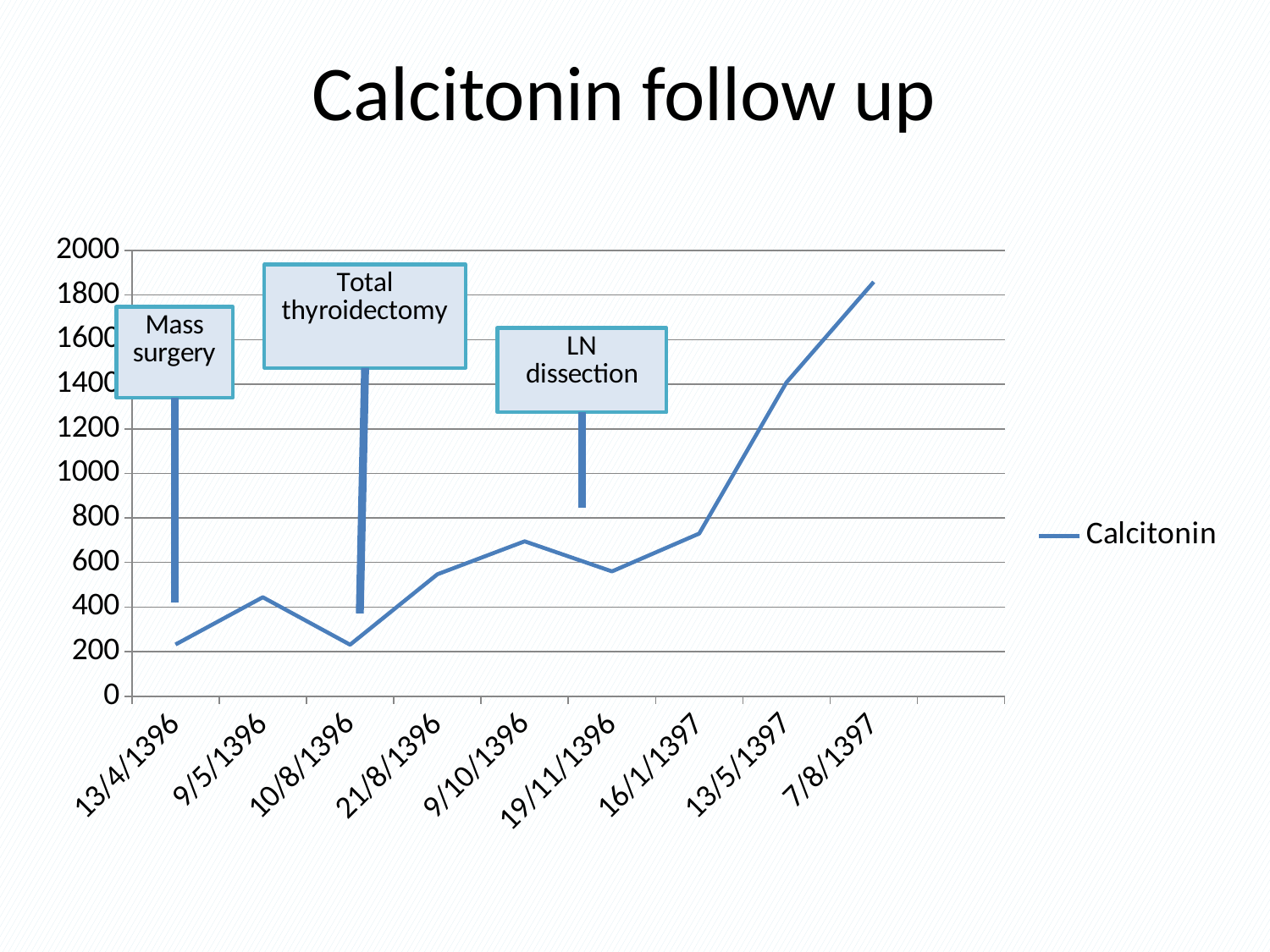
Which has the larger calcitonin value, 13/5/1397 or 9/10/1396? 13/5/1397 Is the calcitonin value for 9/10/1396 greater or less than 800? less What kind of chart is shown on the slide? line chart On which date is the calcitonin value highest? 7/8/1397 Is the calcitonin value for 7/8/1397 greater or less than 1600? greater Does the calcitonin value rise or fall between 16/1/1397 and 7/8/1397? rise How many dates are shown on the x axis? 9 How many series does the legend list? 1 What is the title of the chart? Calcitonin follow up Is the calcitonin value for 16/1/1397 greater or less than 600? greater What is the name of the series shown in the legend? Calcitonin